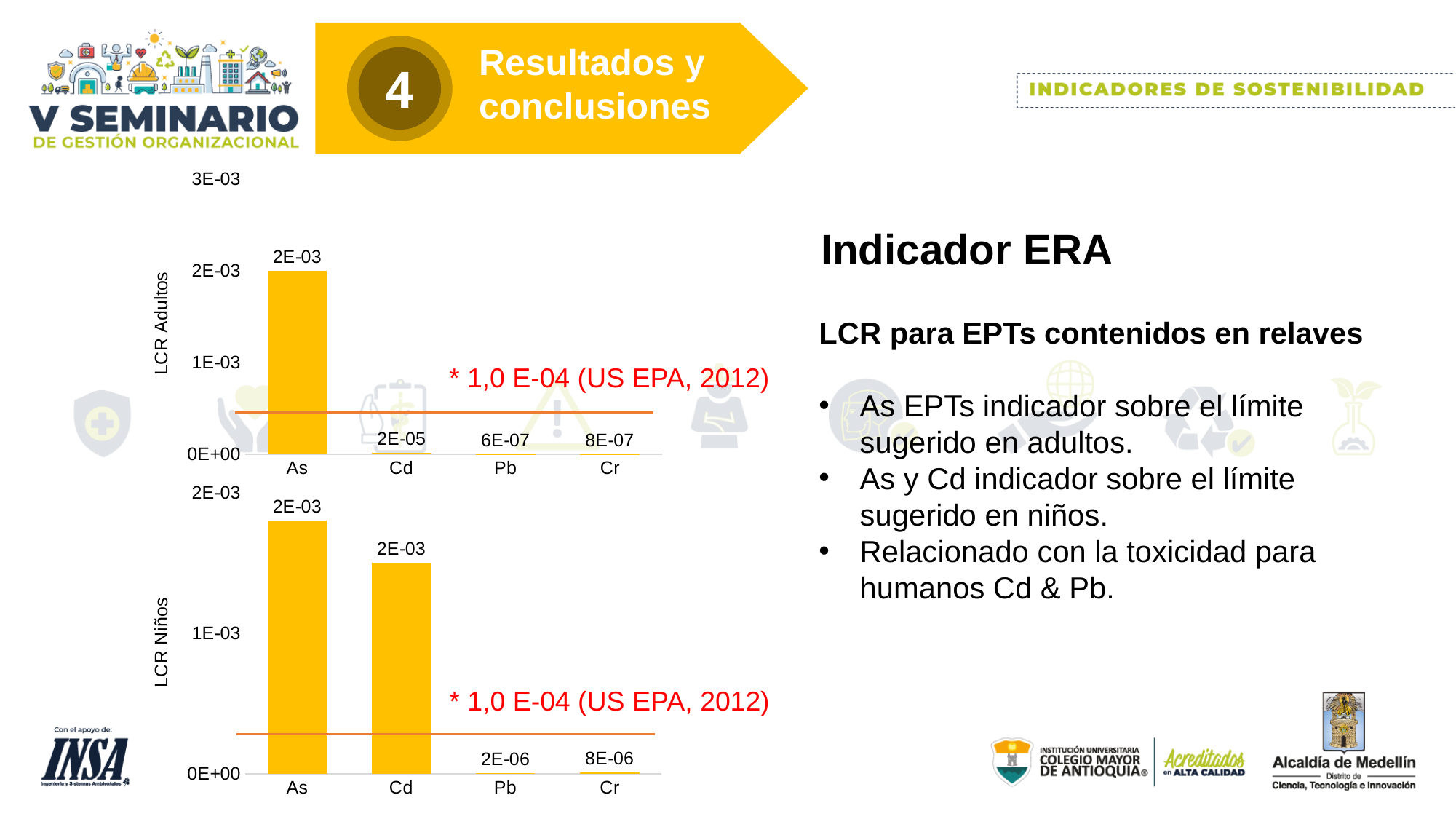
In the bottom chart (LCR Niños), what is the value for Cr? 8E-06 In the bottom chart (LCR Niños), which category has the lowest value? Pb In the top chart (LCR Adultos), what is the value for Cd? 2E-05 In the top chart (LCR Adultos), is the value for As greater or less than 1E-03? greater In the top chart (LCR Adultos), what is the value for Pb? 6E-07 In the top chart (LCR Adultos), which category has the lowest value? Pb In the bottom chart (LCR Niños), is the value for Cd greater or less than 1E-03? greater In the top chart (LCR Adultos), what is the value for As? 2E-03 In the top chart (LCR Adultos), which category has the highest value? As How many categories are shown on the x axis of the bottom chart (LCR Niños)? 4 What kind of chart is the top chart (LCR Adultos)? bar chart In the bottom chart (LCR Niños), what is the value for Pb? 2E-06